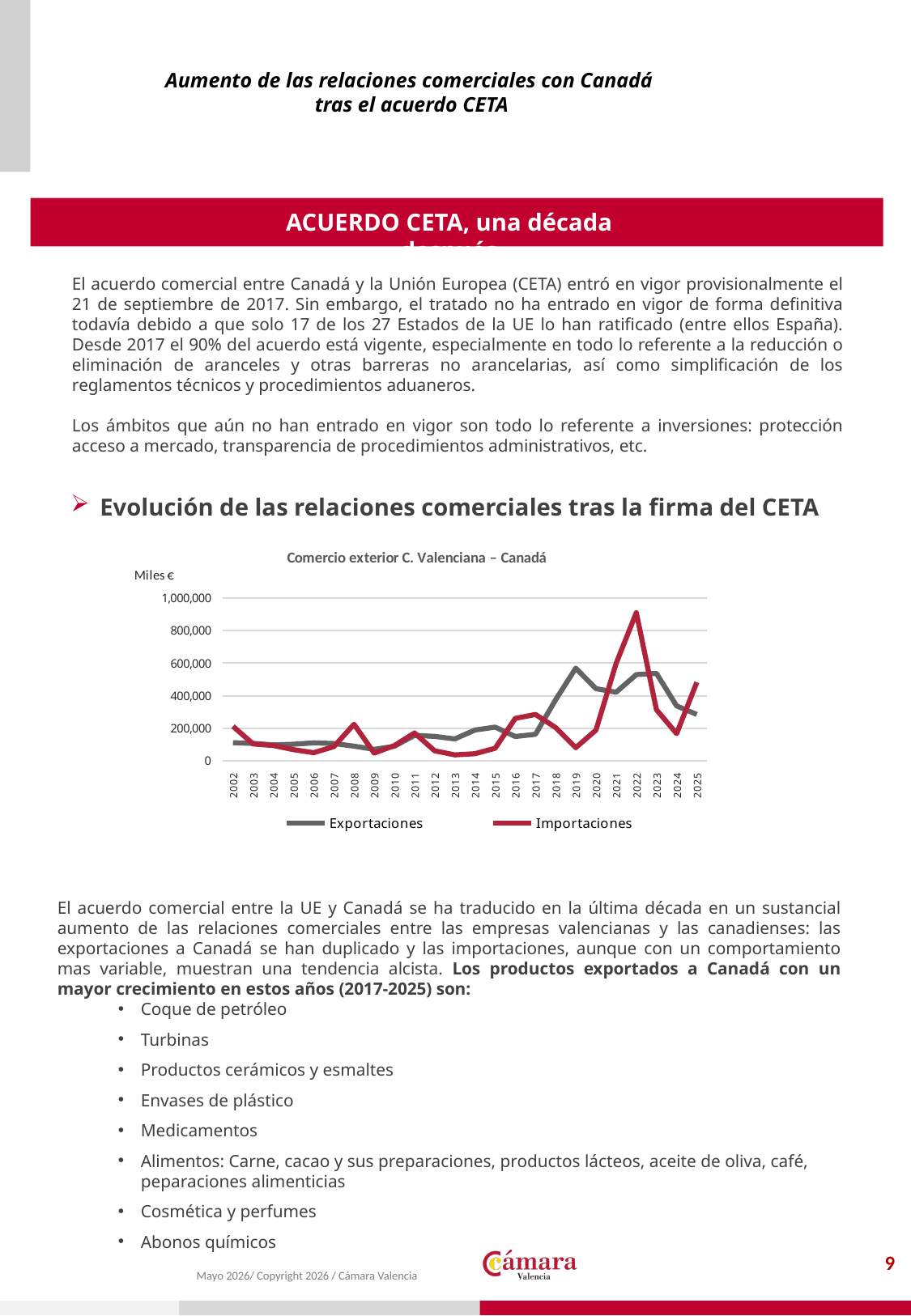
Is the value for Exportaciones in 2002 greater or less than 200,000? less Is the value for Importaciones in 2019 greater or less than 200,000? less How many series does the chart legend list? 2 What is the title of the chart? Comercio exterior C. Valenciana – Canadá Is the value for Exportaciones in 2019 greater or less than 400,000? greater In 2022, which series has the larger value, Exportaciones or Importaciones? Importaciones What kind of chart is shown on the slide? Line chart What unit is shown on the y axis of the chart? Miles € In which year does the Importaciones series reach its highest value? 2022 In 2019, which series has the larger value, Exportaciones or Importaciones? Exportaciones How many years are plotted along the x axis of the chart? 24